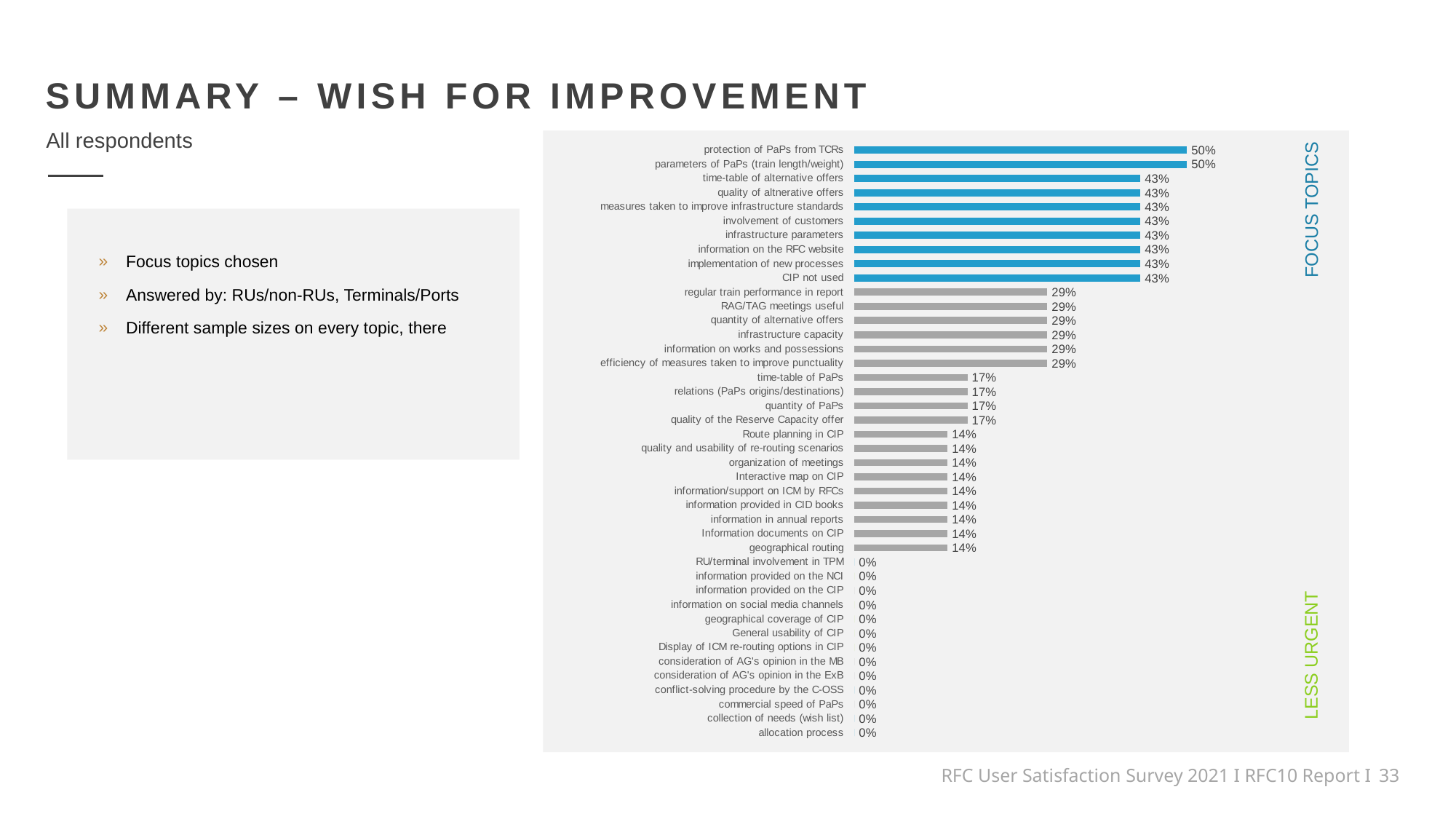
What is the highest value shown in the chart? 50% What is the value for 'quantity of PaPs'? 17% Which is larger, the value for 'RAG/TAG meetings useful' or the value for 'relations (PaPs origins/destinations)'? RAG/TAG meetings useful How many categories are plotted in the chart? 42 What is the value for 'infrastructure capacity'? 29% What is the value for 'geographical routing'? 14% What kind of chart is shown on the slide? bar chart What is the value for 'CIP not used'? 43% What label is written vertically next to the blue bars at the top of the chart? FOCUS TOPICS What is the difference between the value for 'time-table of alternative offers' and the value for 'Route planning in CIP'? 29% What is the value for 'allocation process'? 0% What is the difference between the value for 'protection of PaPs from TCRs' and the value for 'regular train performance in report'? 21%